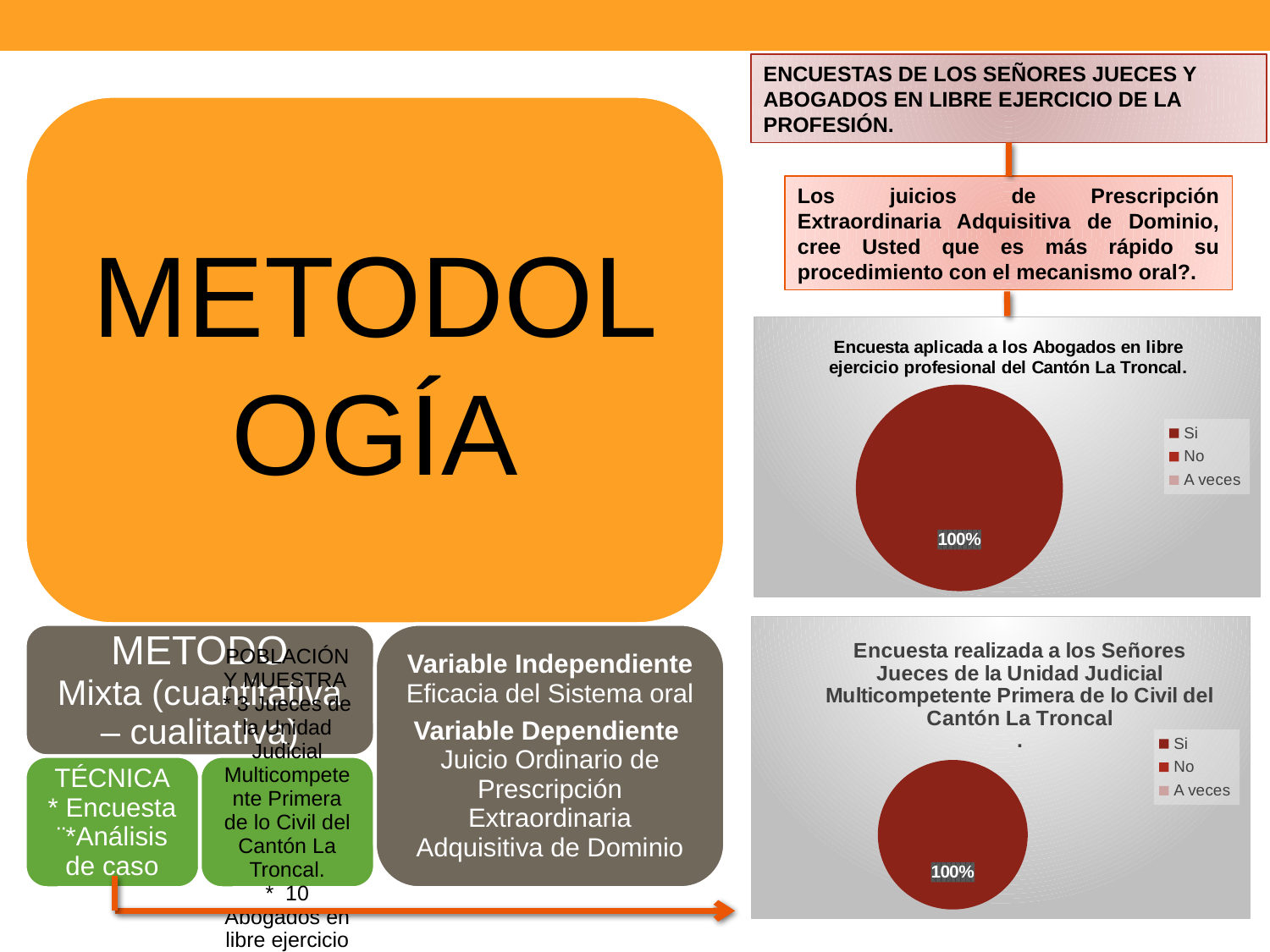
In the chart titled "Encuesta aplicada a los Abogados en libre ejercicio profesional del Cantón La Troncal.", which category has the largest share? Si In the chart titled "Encuesta realizada a los Señores Jueces de la Unidad Judicial Multicompetente Primera de lo Civil del Cantón La Troncal", which category has the largest share? Si What kind of chart is the chart titled "Encuesta realizada a los Señores Jueces de la Unidad Judicial Multicompetente Primera de lo Civil del Cantón La Troncal"? pie chart In the chart titled "Encuesta aplicada a los Abogados en libre ejercicio profesional del Cantón La Troncal.", what share of the pie does the "Si" slice take? 100% How many entries does the legend list in the chart titled "Encuesta realizada a los Señores Jueces de la Unidad Judicial Multicompetente Primera de lo Civil del Cantón La Troncal"? 3 In the chart titled "Encuesta aplicada a los Abogados en libre ejercicio profesional del Cantón La Troncal.", is the share for "Si" larger than the share for "No"? Yes What kind of chart is the chart titled "Encuesta aplicada a los Abogados en libre ejercicio profesional del Cantón La Troncal."? pie chart In the chart titled "Encuesta realizada a los Señores Jueces de la Unidad Judicial Multicompetente Primera de lo Civil del Cantón La Troncal", what percentage is printed on the pie? 100% In the chart titled "Encuesta realizada a los Señores Jueces de la Unidad Judicial Multicompetente Primera de lo Civil del Cantón La Troncal", what colour is the "Si" slice? dark red How many entries does the legend list in the chart titled "Encuesta aplicada a los Abogados en libre ejercicio profesional del Cantón La Troncal."? 3 In the chart titled "Encuesta aplicada a los Abogados en libre ejercicio profesional del Cantón La Troncal.", what are the legend entries? Si, No, A veces